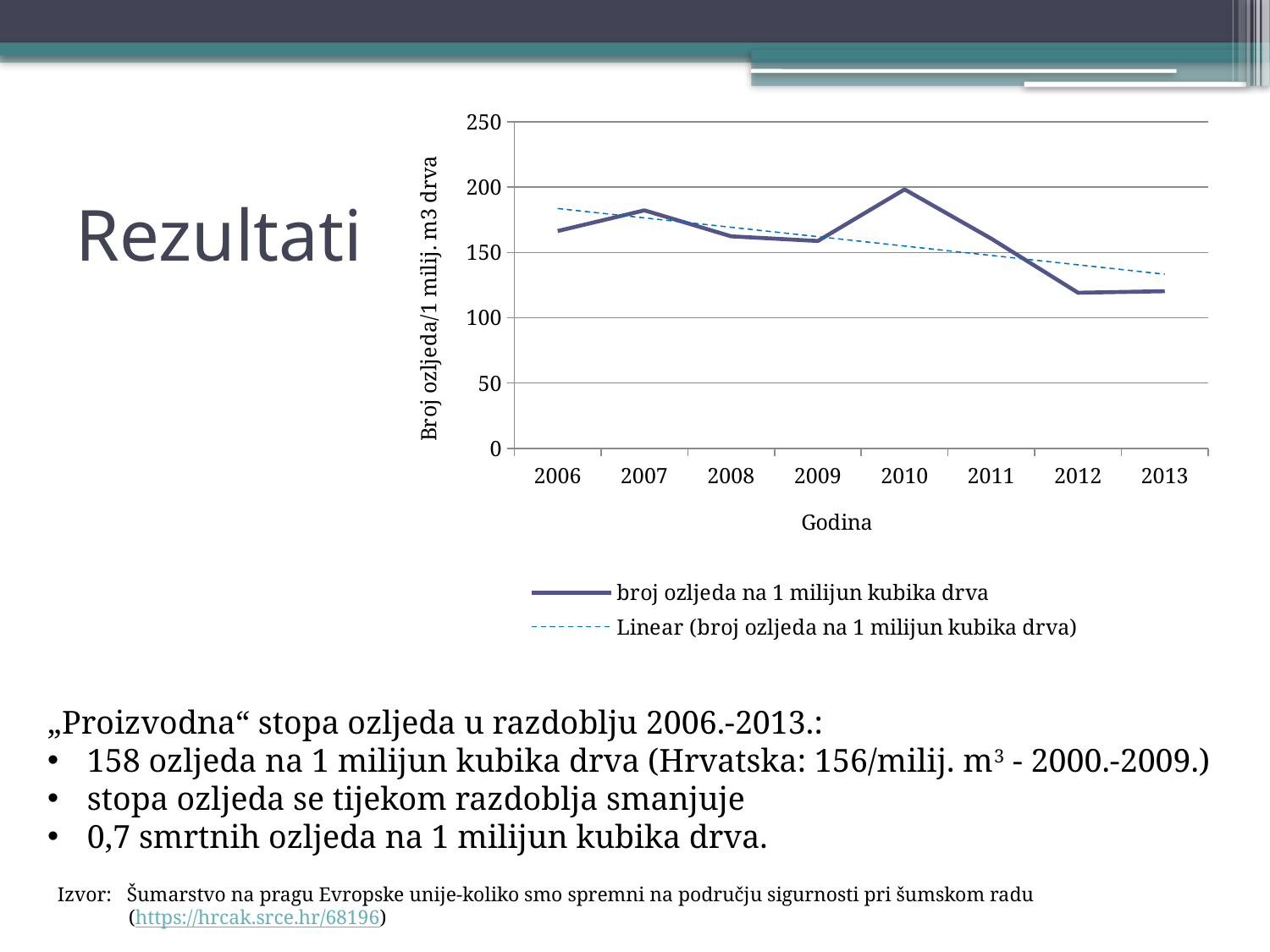
What is the label of the x axis? Godina Is the value for 2007 greater or less than 200? less Is the value for 2012 greater or less than 150? less How many entries does the legend list? 2 Is the value for 2010 greater or less than 150? greater How many years are plotted on the x axis? 8 Which is larger, the value for 2007 or the value for 2013? 2007 Which is larger, the value for 2010 or the value for 2012? 2010 Which year has the highest value for broj ozljeda na 1 milijun kubika drva? 2010 What kind of chart is shown on the slide? line chart Does the linear trend line rise or fall from 2006 to 2013? fall